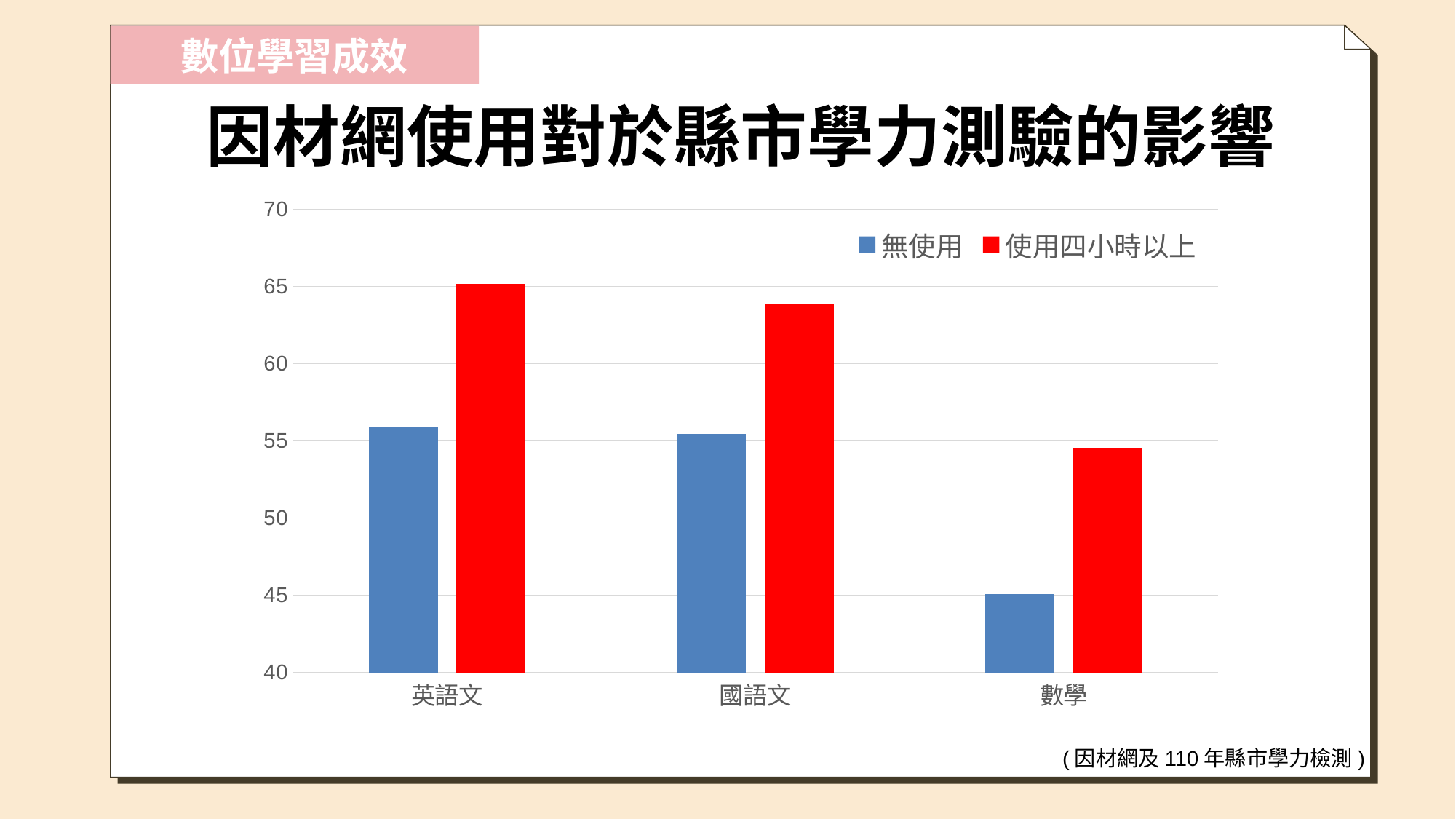
Is the value for 數學 使用四小時以上 greater or less than 50? greater What colour are the bars for 使用四小時以上? red How many subject categories are shown on the x axis? 3 Which subject has the lowest value for 無使用? 數學 Is the value for 國語文 使用四小時以上 greater or less than 65? less What kind of chart is shown on the slide? bar chart For 數學, which is larger: 無使用 or 使用四小時以上? 使用四小時以上 What is the title of the chart? 因材網使用對於縣市學力測驗的影響 Is the value for 數學 無使用 greater or less than 50? less How many series does the legend list? 2 Which subject has the highest value for 使用四小時以上? 英語文